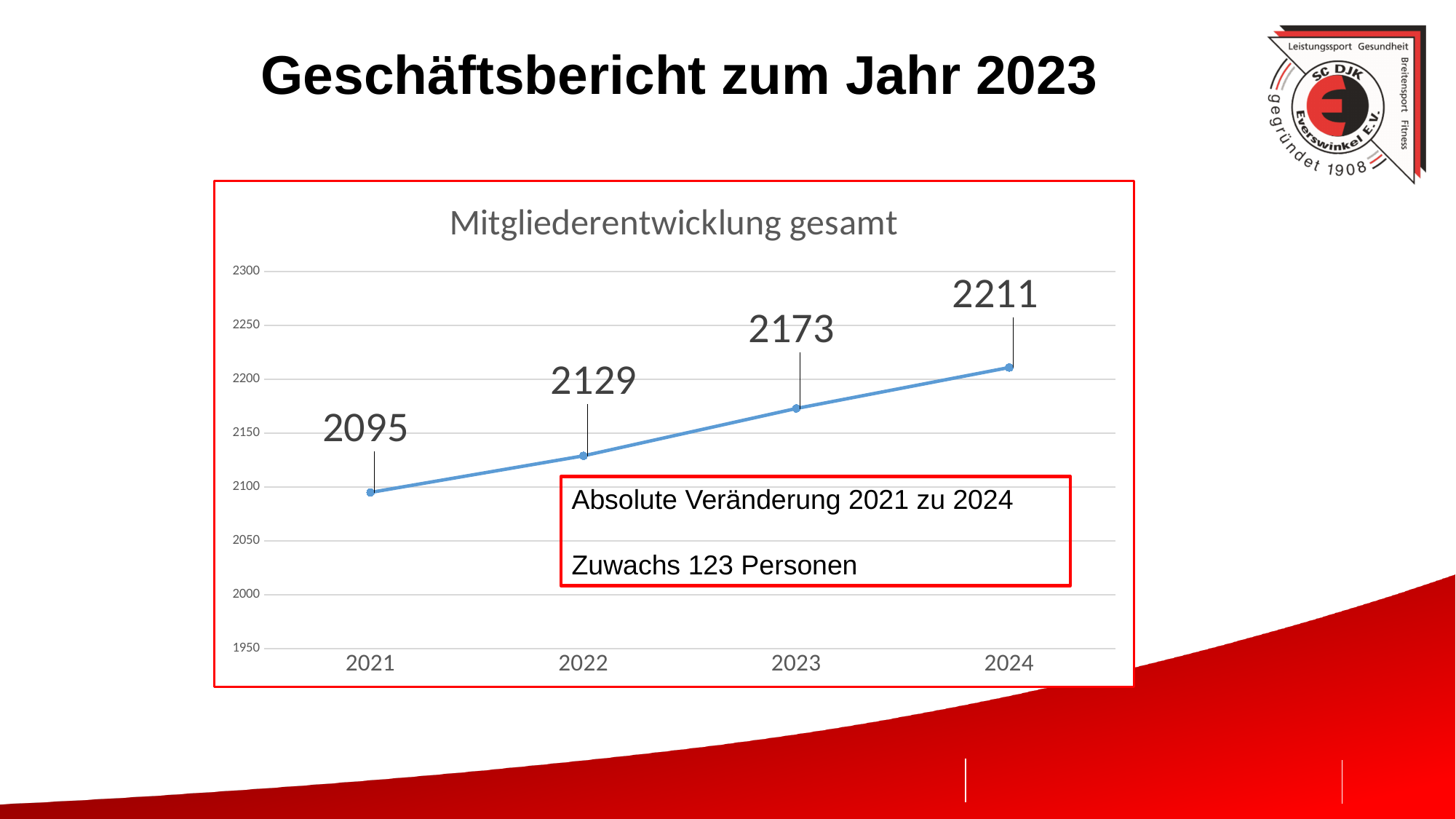
Do the values rise or fall from 2021 to 2024? rise What is the value for 2024? 2211 Which is larger, the value for 2022 or the value for 2023? 2023 What is the value for 2021? 2095 What kind of chart is shown? line chart What is the value for 2022? 2129 What is the difference between the values for 2024 and 2021? 116 Which year has the highest value? 2024 What is the value for 2023? 2173 What is the difference between the values for 2023 and 2022? 44 How many data points are plotted on the chart? 4 Which year has the lowest value? 2021